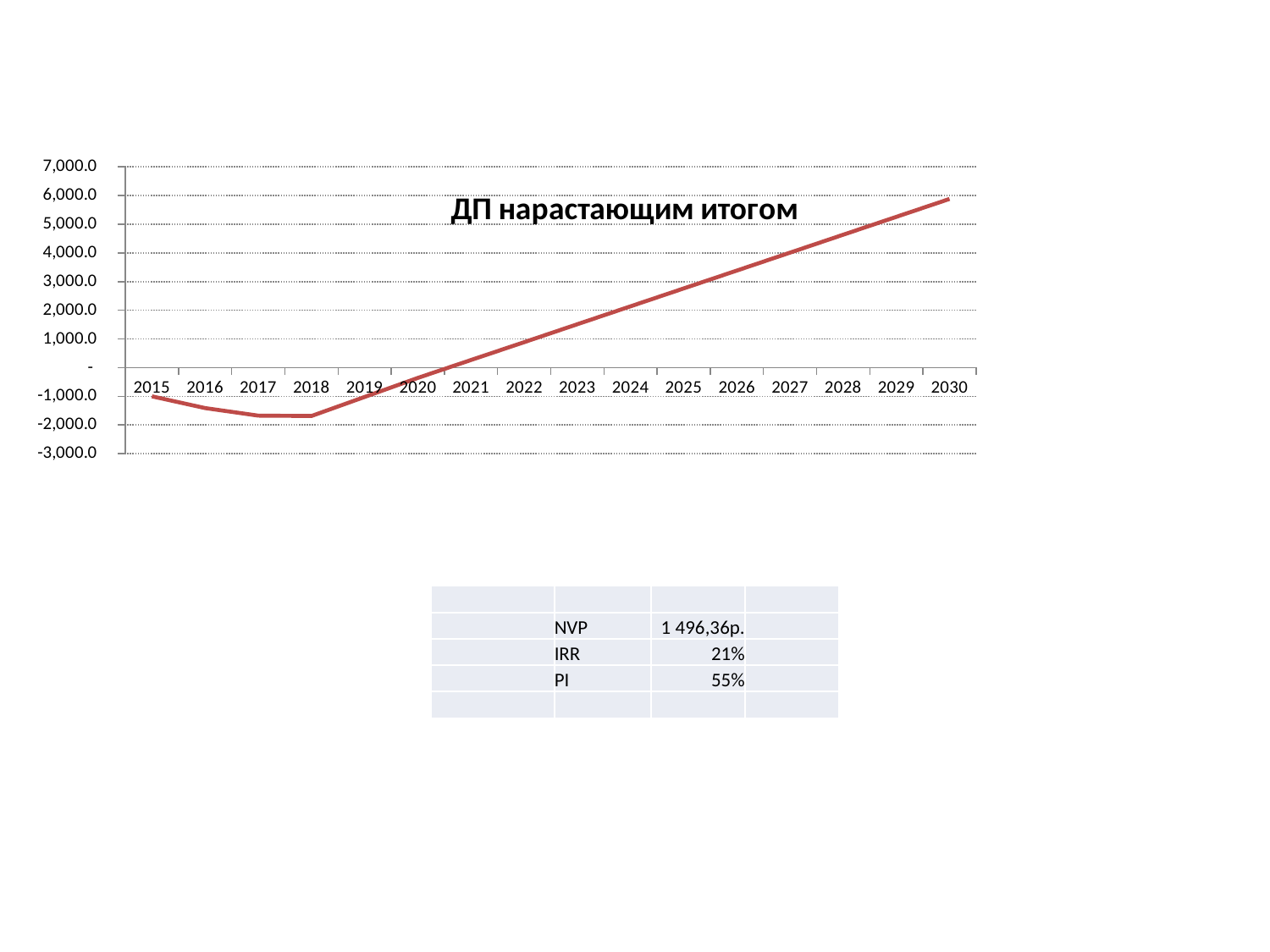
Which year has the highest value on the chart? 2030 Do the values rise or fall from 2015 to 2017? fall Is the value for 2025 greater or less than 2,000.0? greater Which is larger, the value for 2015 or the value for 2030? 2030 Is the value for 2018 greater or less than -1,000.0? less What kind of chart is shown on the slide? line chart Is the value for 2030 greater or less than 5,000.0? greater What is the title of the chart? ДП нарастающим итогом Do the values rise or fall from 2018 to 2030? rise How many years are plotted on the x axis of the chart? 16